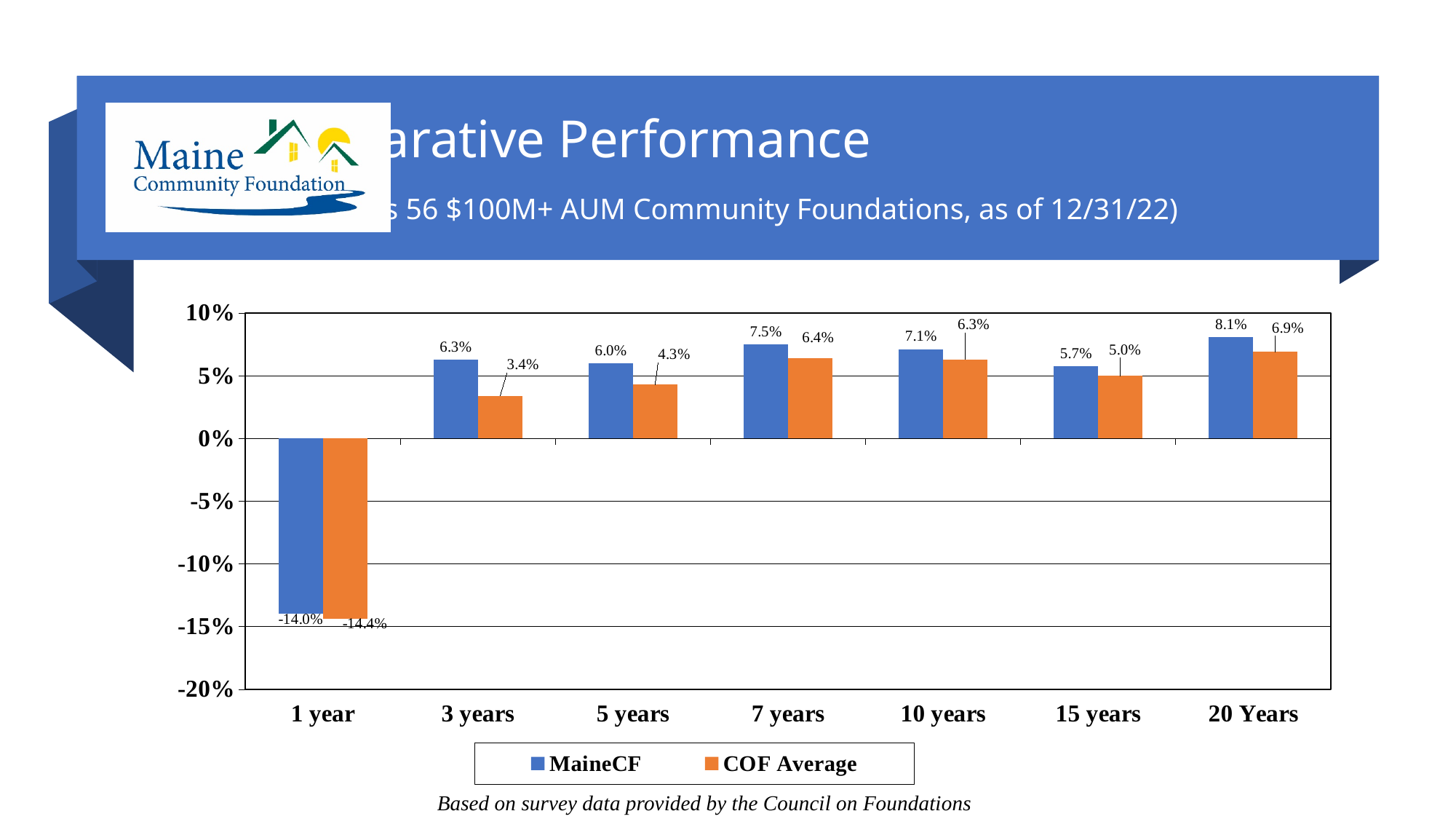
Which is larger for 15 years, MaineCF or COF Average? MaineCF Which period has the lowest COF Average value? 1 year What is the COF Average value for 20 Years? 6.9% What kind of chart is shown on the slide? Bar chart Which period has the highest MaineCF value? 20 Years How many series does the legend list? 2 What is the COF Average value for 3 years? 3.4% Which colour represents COF Average in the chart? Orange What is the MaineCF value for 1 year? -14.0% How many periods are shown on the x axis? 7 What is the difference between the MaineCF and COF Average values for 3 years? 2.9% What is the MaineCF value for 7 years? 7.5%